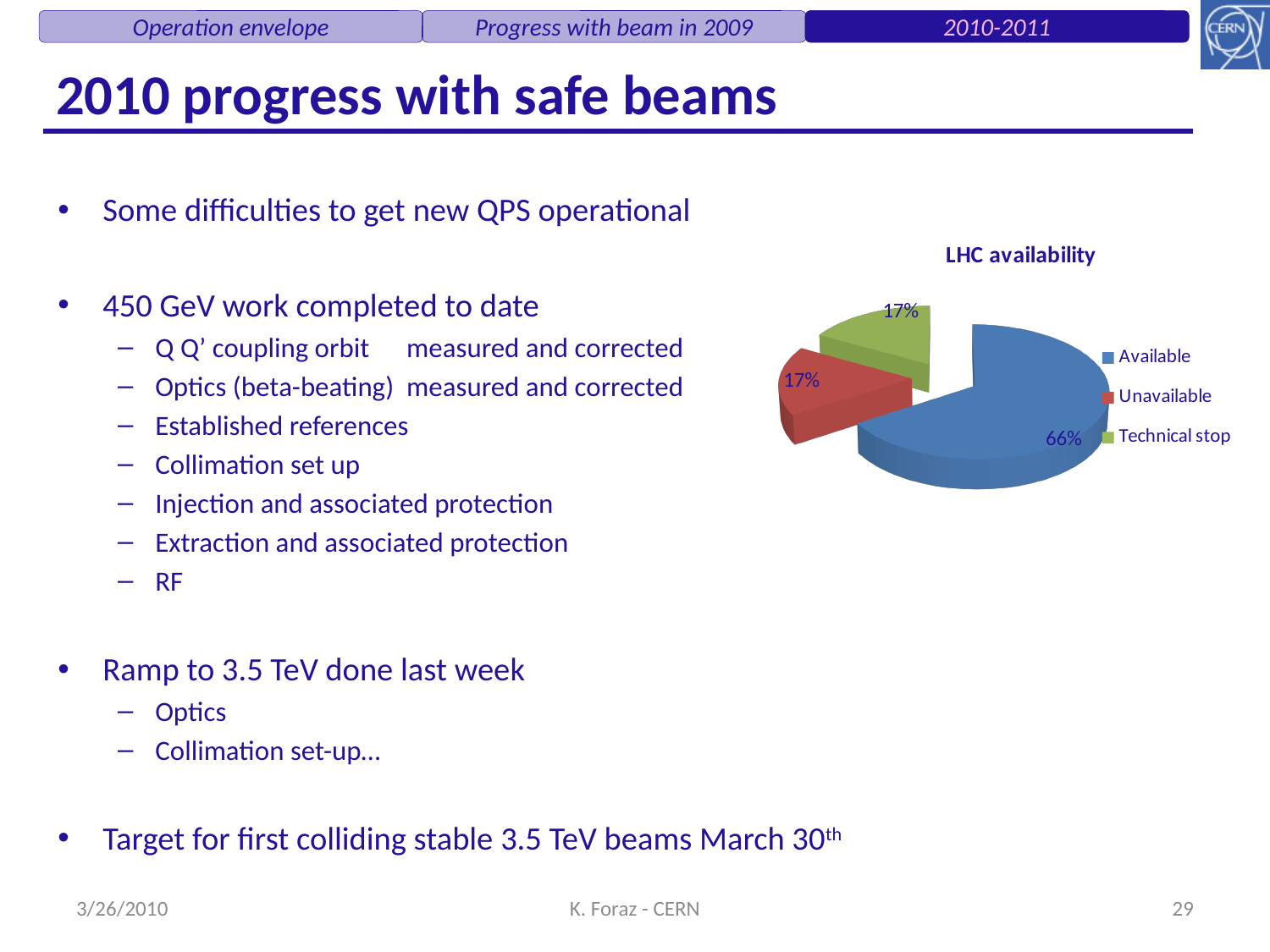
What kind of chart is shown on the slide? pie chart What share of the pie is labelled Available? 66% Which is larger, the Available slice or the Technical stop slice? Available Which category has the largest slice of the pie? Available What share of the pie is labelled Technical stop? 17% How many categories does the legend list? 3 Is the Available share greater or less than 50%? greater Which colour represents Technical stop in the chart? green What is the combined share of Unavailable and Technical stop? 34% What is the difference between the Available share and the Unavailable share? 49% What is the title of the chart? LHC availability What share of the pie is labelled Unavailable? 17%